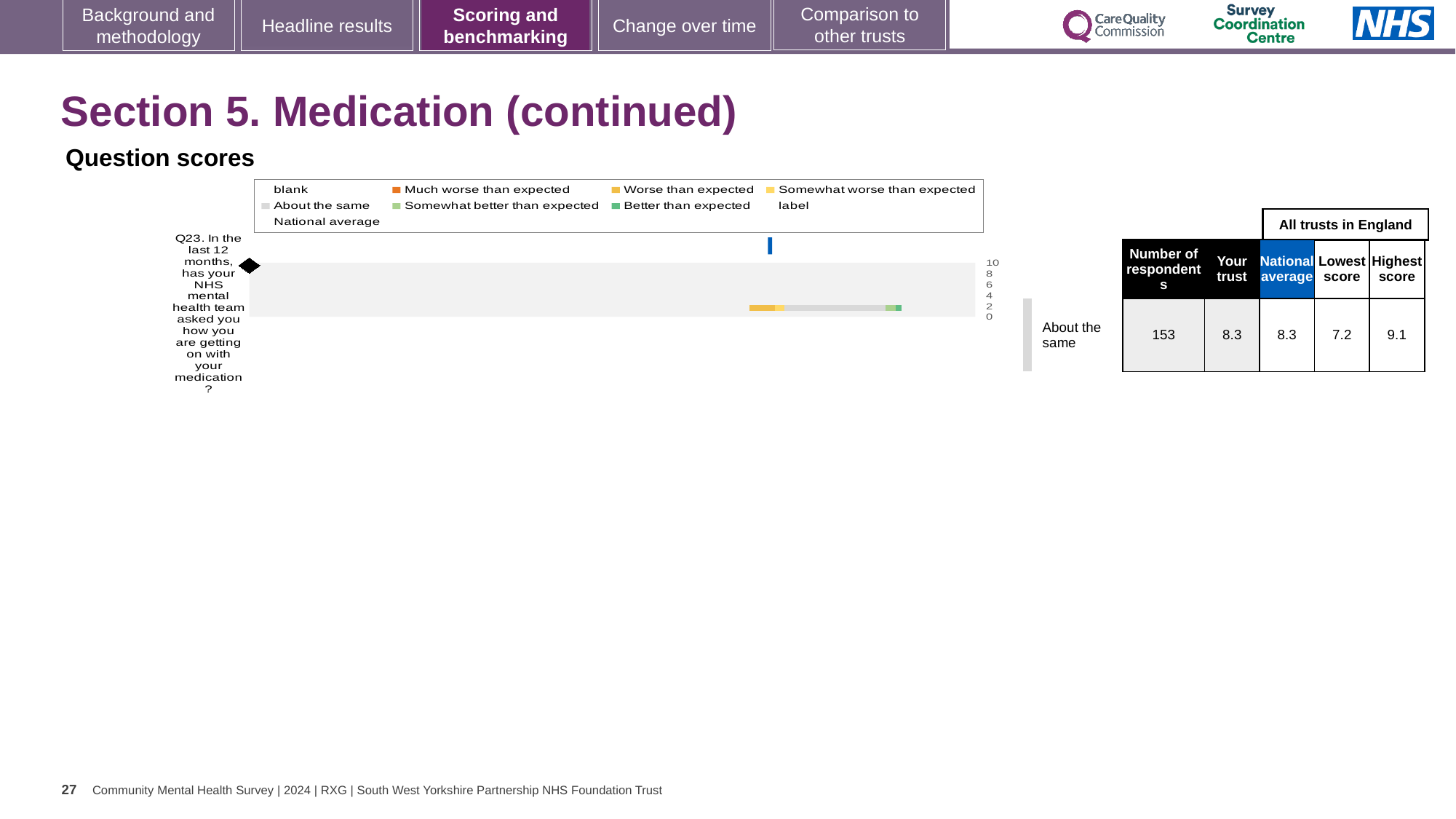
Which question is plotted in the Question scores chart? Q23. In the last 12 months, has your NHS mental health team asked you how you are getting on with your medication? How many questions (categories) are plotted in the Question scores chart? 1 In the chart legend, what colour represents "Much worse than expected"? orange What kind of chart is shown under "Question scores"? bar chart In the table beside the chart, what is the national average score for Q23? 8.3 Is the "Your trust" score for Q23 larger than, smaller than, or equal to the national average? equal In the table beside the chart, what is the lowest score among all trusts in England for Q23? 7.2 In the table beside the chart, how many respondents answered Q23? 153 In the table beside the chart, what is the highest score among all trusts in England for Q23? 9.1 In the table beside the chart, what is the "Your trust" score for Q23? 8.3 What benchmark category is shown for Q23 next to the chart? About the same What is the difference between the highest score and the lowest score for Q23 in the table beside the chart? 1.9